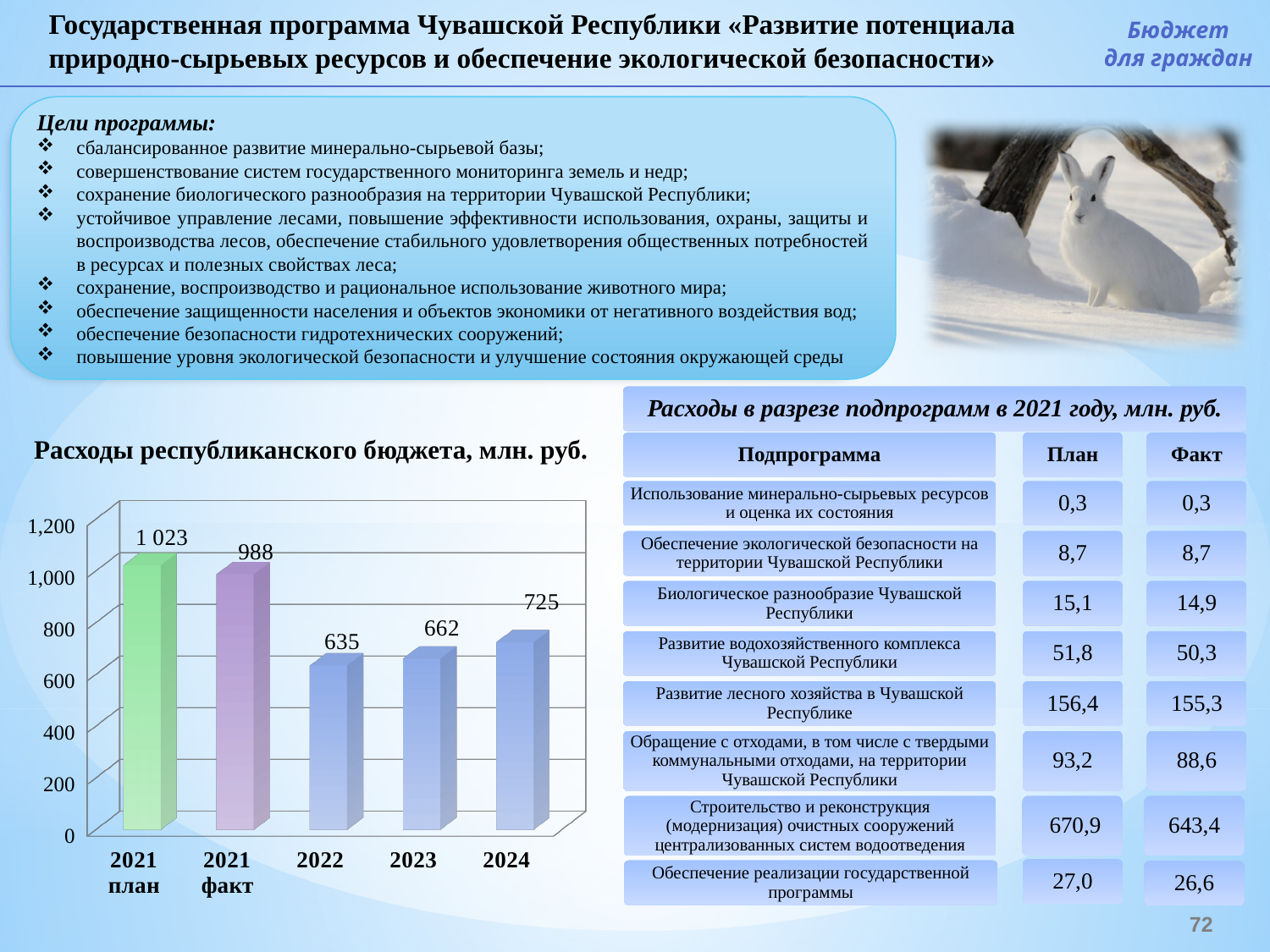
What is the difference between the 2024 and 2023 values in the chart «Расходы республиканского бюджета, млн. руб.»? 63 How many categories are shown on the x axis of the chart «Расходы республиканского бюджета, млн. руб.»? 5 What is the difference between the 2021 план and 2021 факт values in the chart «Расходы республиканского бюджета, млн. руб.»? 35 In the chart «Расходы республиканского бюджета, млн. руб.», is the value for 2021 факт greater or less than 800? greater Which category has the highest value in the chart «Расходы республиканского бюджета, млн. руб.»? 2021 план What is the value for 2021 факт in the chart «Расходы республиканского бюджета, млн. руб.»? 988 In the chart «Расходы республиканского бюджета, млн. руб.», which is larger: the value for 2022 or the value for 2023? 2023 What is the value for 2021 план in the chart «Расходы республиканского бюджета, млн. руб.»? 1 023 What is the value for 2024 in the chart «Расходы республиканского бюджета, млн. руб.»? 725 In the chart «Расходы республиканского бюджета, млн. руб.», do the values rise or fall from 2022 to 2024? rise What kind of chart is «Расходы республиканского бюджета, млн. руб.»? bar chart Which category has the lowest value in the chart «Расходы республиканского бюджета, млн. руб.»? 2022